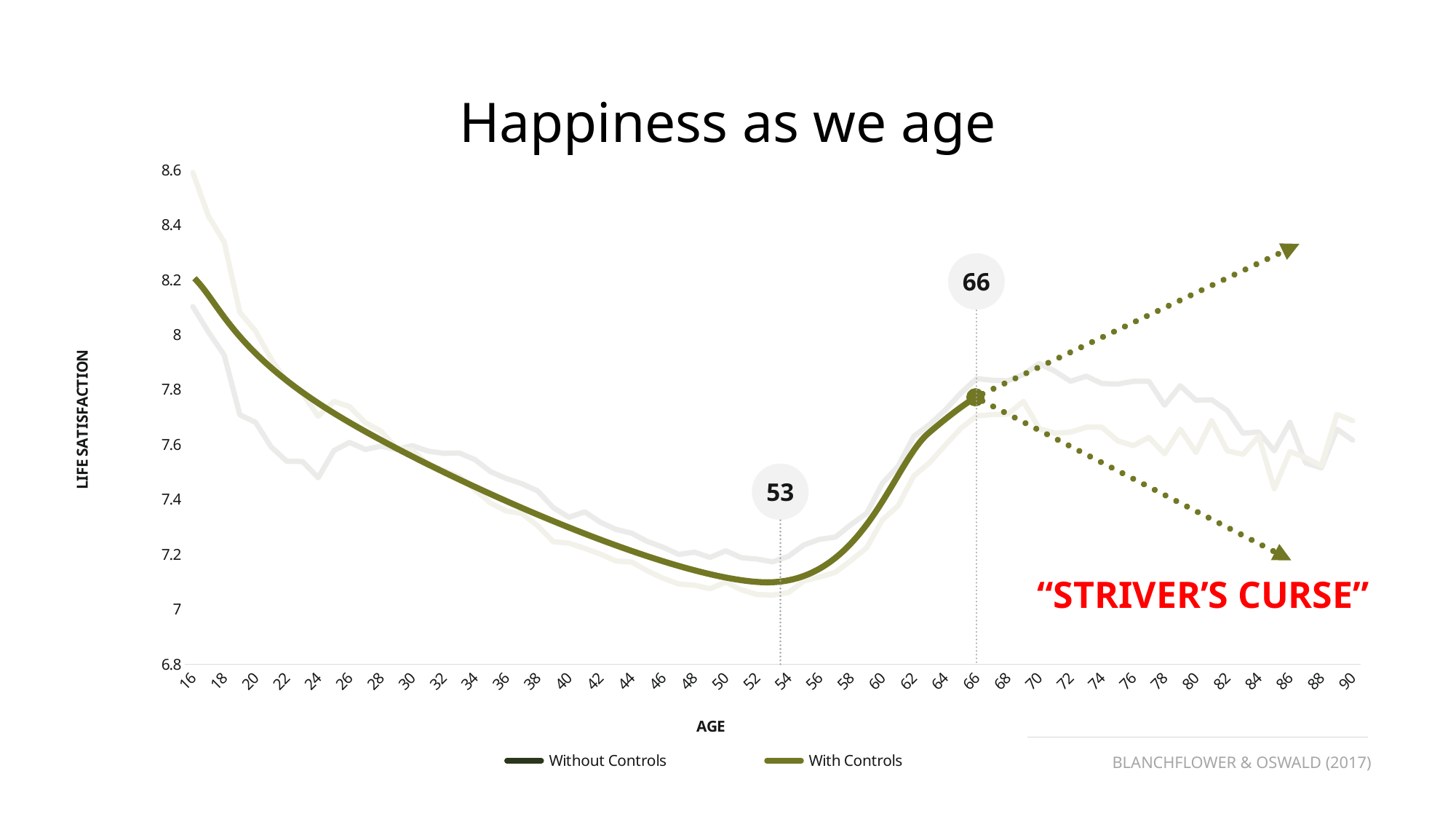
What are the two series named in the legend? Without Controls and With Controls Does life satisfaction rise or fall along the x axis between age 53 and age 66? rise What is the title of the chart? Happiness as we age What is the label of the x axis? AGE What kind of chart is shown on the slide? line chart Does life satisfaction rise or fall along the x axis between age 16 and age 53? fall At what age does the chart mark the peak of life satisfaction after the low point? 66 Is the life satisfaction value at age 66 greater or less than 7.6? greater At what age does the chart mark the lowest point of life satisfaction? 53 How many series does the legend list? 2 What is the label of the y axis? LIFE SATISFACTION Is the life satisfaction value at age 53 greater or less than 7.2? less